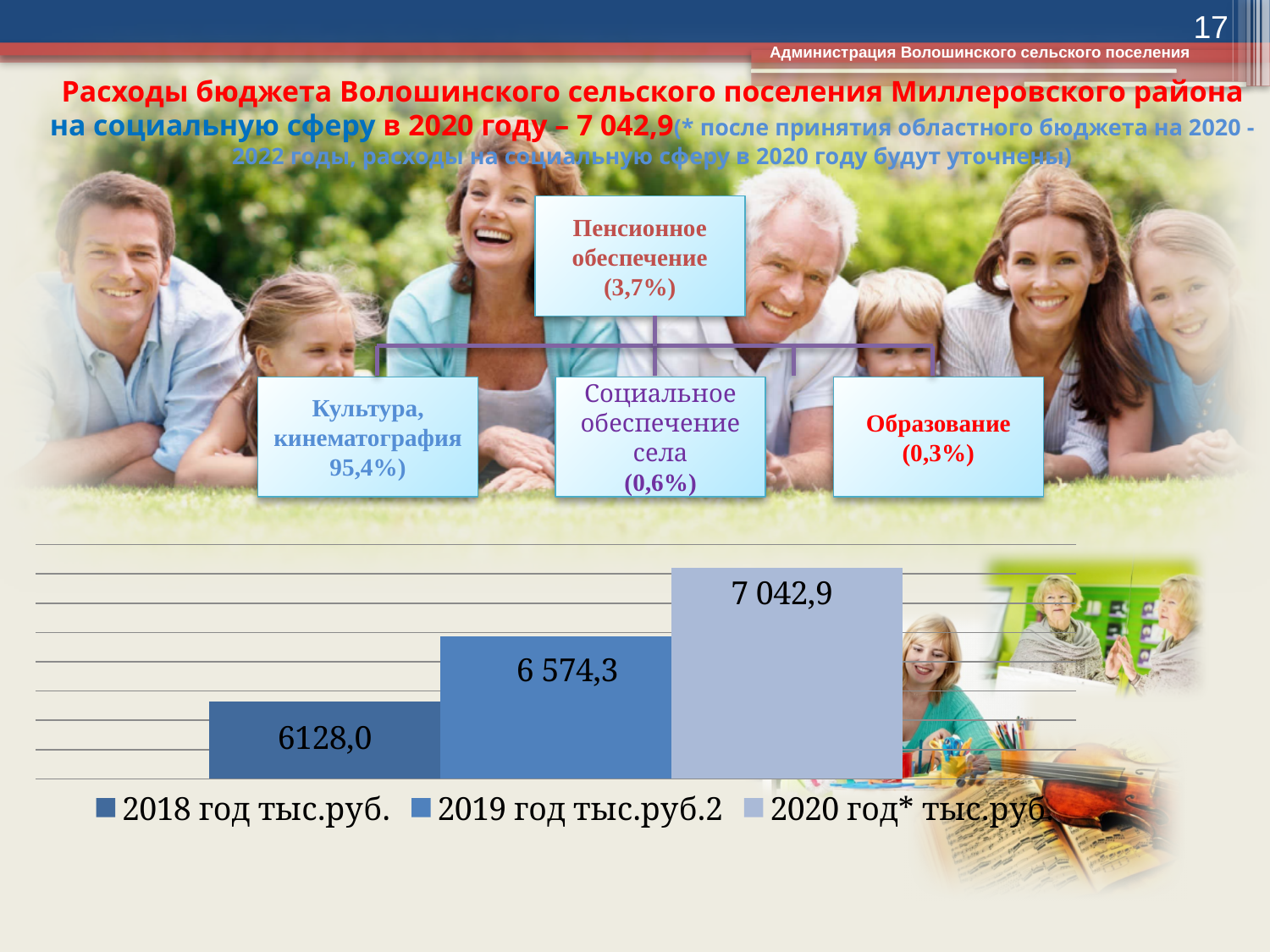
What value is shown for 2020 год* тыс.руб in the bar chart? 7 042,9 How many bars are plotted in the bar chart? 3 How many series does the legend of the bar chart list? 3 Do the values in the bar chart rise or fall from 2018 to 2020? rise Which year has the highest value in the bar chart? 2020 год* тыс.руб What value is shown for 2019 год тыс.руб.2 in the bar chart? 6 574,3 Which year has the lowest value in the bar chart? 2018 год тыс.руб. What is the difference between the 2019 год value and the 2018 год value in the bar chart? 446,3 What is the difference between the 2020 год* value and the 2019 год value in the bar chart? 468,6 What kind of chart is shown at the bottom of the slide? bar chart Which is larger in the bar chart, the value for 2019 год or the value for 2018 год? 2019 год What value is shown for 2018 год тыс.руб. in the bar chart? 6128,0